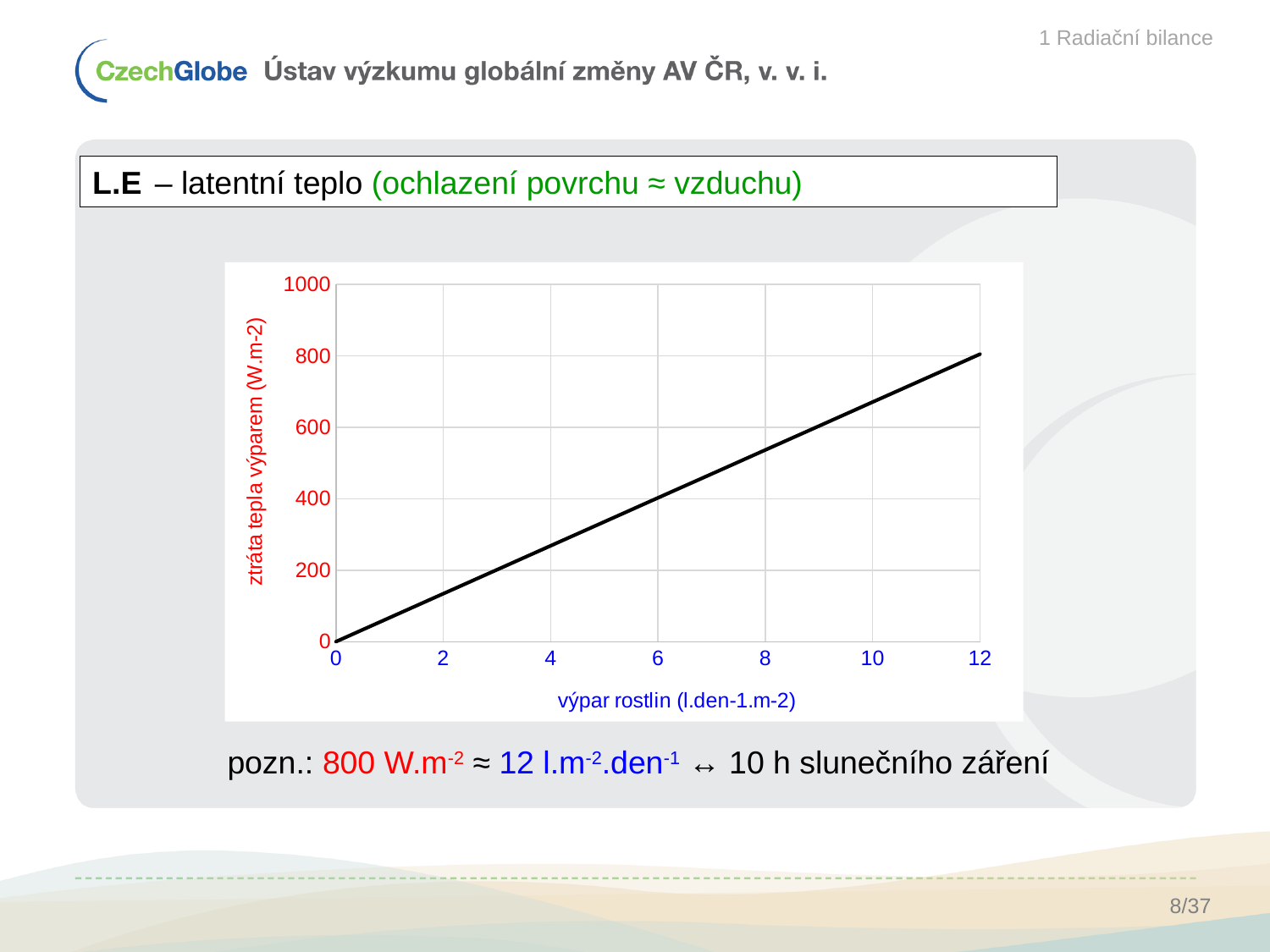
What is the label of the y axis of the chart? ztráta tepla výparem (W.m-2) Is the heat loss at a plant evaporation of 4 l.den-1.m-2 greater or less than 400? less Is the heat loss at a plant evaporation of 10 l.den-1.m-2 greater or less than 600? greater What is the highest value shown on the y axis of the chart? 1000 What is the label of the x axis of the chart? výpar rostlin (l.den-1.m-2) What is the heat loss when plant evaporation is 0 l.den-1.m-2? 0 Is the heat loss at a plant evaporation of 2 l.den-1.m-2 greater or less than 200? less Which is larger: the heat loss at 8 l.den-1.m-2 or at 4 l.den-1.m-2 of plant evaporation? 8 l.den-1.m-2 Does the heat loss by evaporation rise or fall as plant evaporation increases along the x axis? rises What kind of chart is shown on the slide? line chart